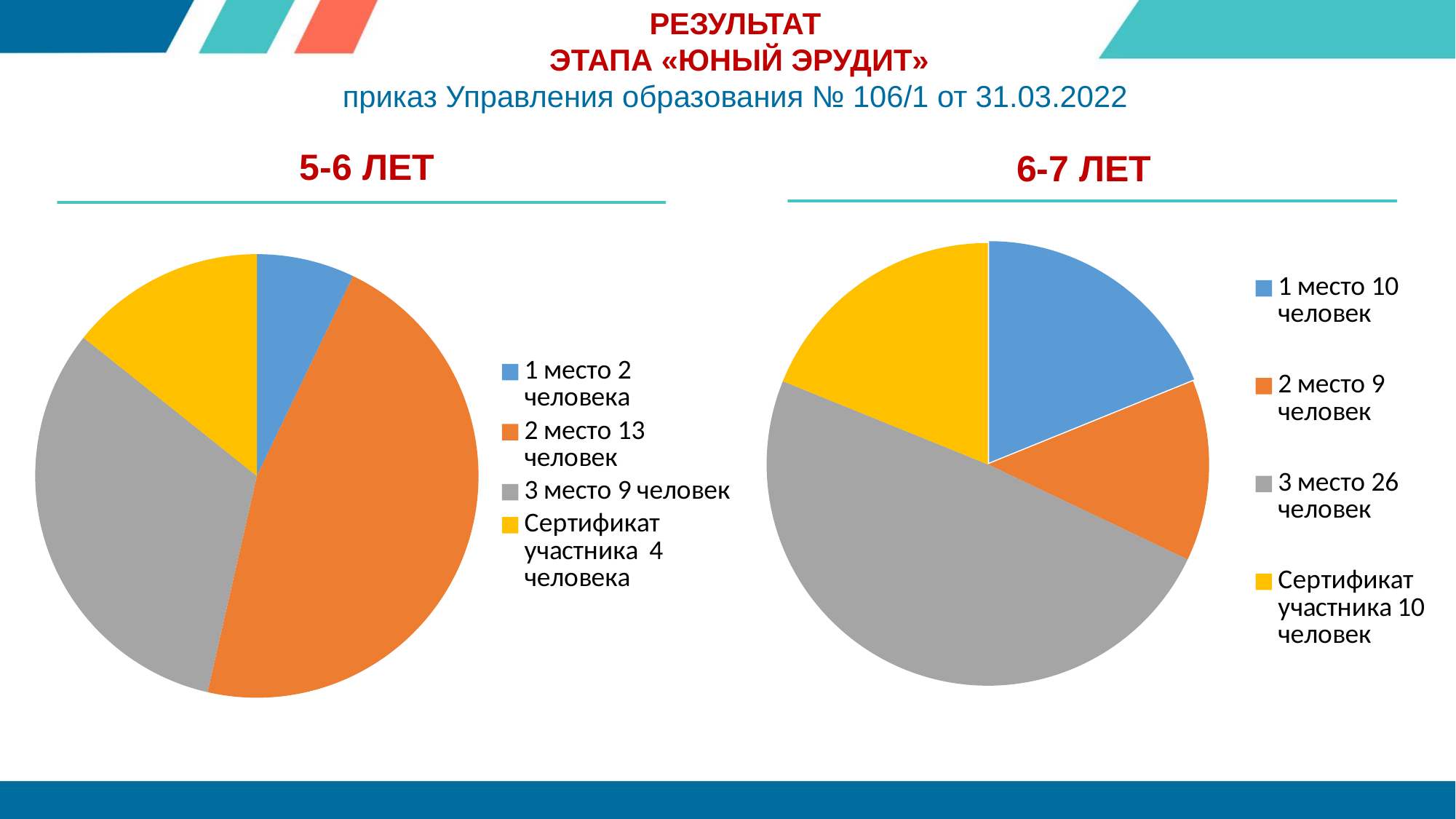
On the 6-7 ЛЕТ chart, what is the total number of participants across all categories? 55 On the 5-6 ЛЕТ chart, what is the difference between the number of people with 2 место and 3 место? 4 What type of chart is used for the 6-7 ЛЕТ data? Pie chart On the 5-6 ЛЕТ chart, how many people took 2 место? 13 человек On the 6-7 ЛЕТ chart, which is larger: 1 место or 2 место? 1 место On the 6-7 ЛЕТ chart, how many people received Сертификат участника? 10 человек On the 6-7 ЛЕТ chart, how many people took 3 место? 26 человек On the 5-6 ЛЕТ chart, which category has the largest slice? 2 место On the 5-6 ЛЕТ chart, which category has the smallest slice? 1 место On the 6-7 ЛЕТ chart, which category has the largest slice? 3 место How many slices does the 5-6 ЛЕТ pie chart have? 4 On the 6-7 ЛЕТ chart, which category has the smallest slice? 2 место